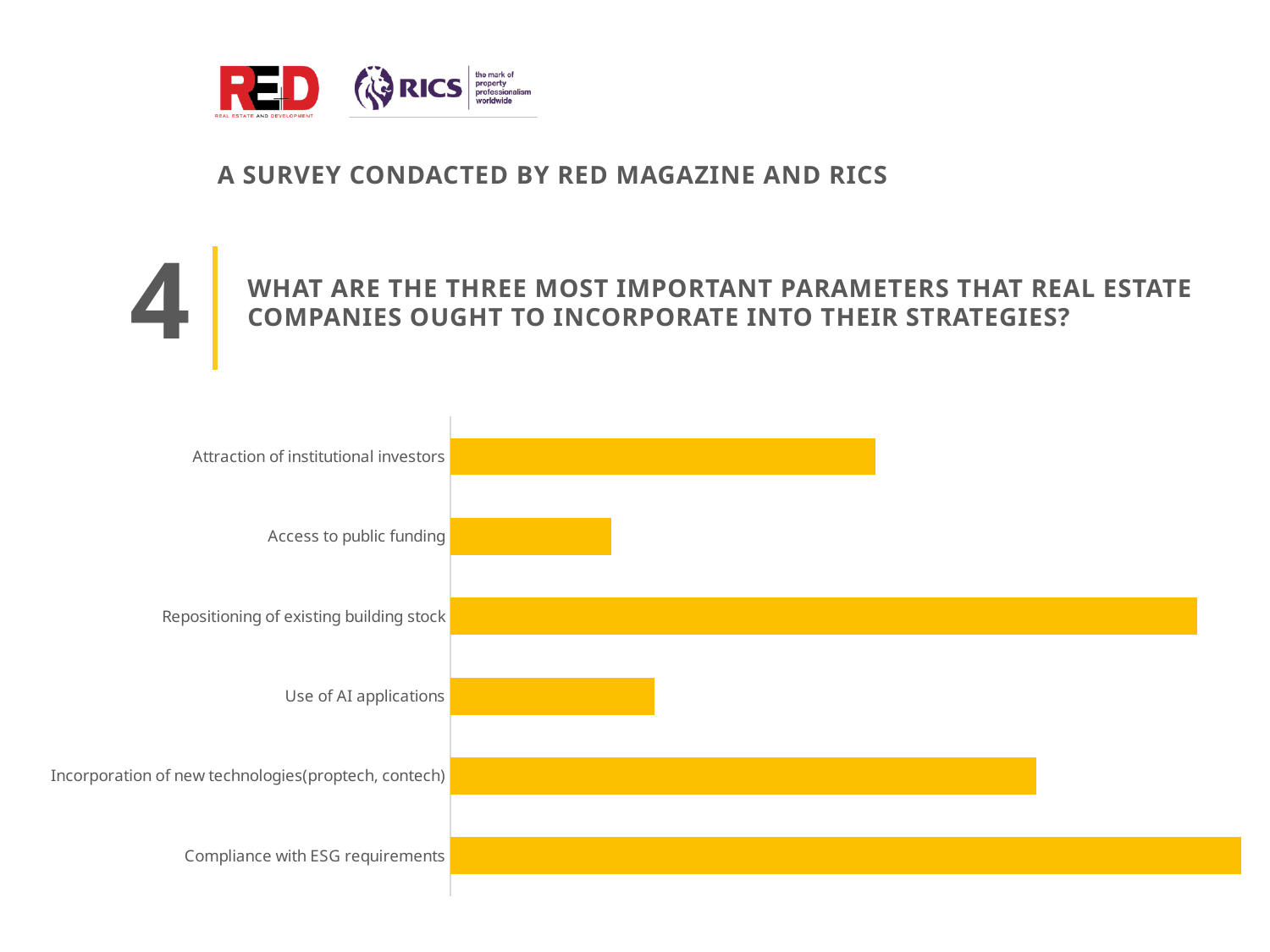
What kind of chart is shown on the slide? bar chart Which is larger, the value for Use of AI applications or the value for Repositioning of existing building stock? Repositioning of existing building stock Which is larger, the value for Repositioning of existing building stock or the value for Access to public funding? Repositioning of existing building stock Which is larger, the value for Incorporation of new technologies(proptech, contech) or the value for Attraction of institutional investors? Incorporation of new technologies(proptech, contech) How many categories are plotted in the chart? 6 Which category has the longest bar in the chart? Compliance with ESG requirements What survey question does the chart on the slide relate to? What are the three most important parameters that real estate companies ought to incorporate into their strategies? What colour are the bars in the chart? yellow